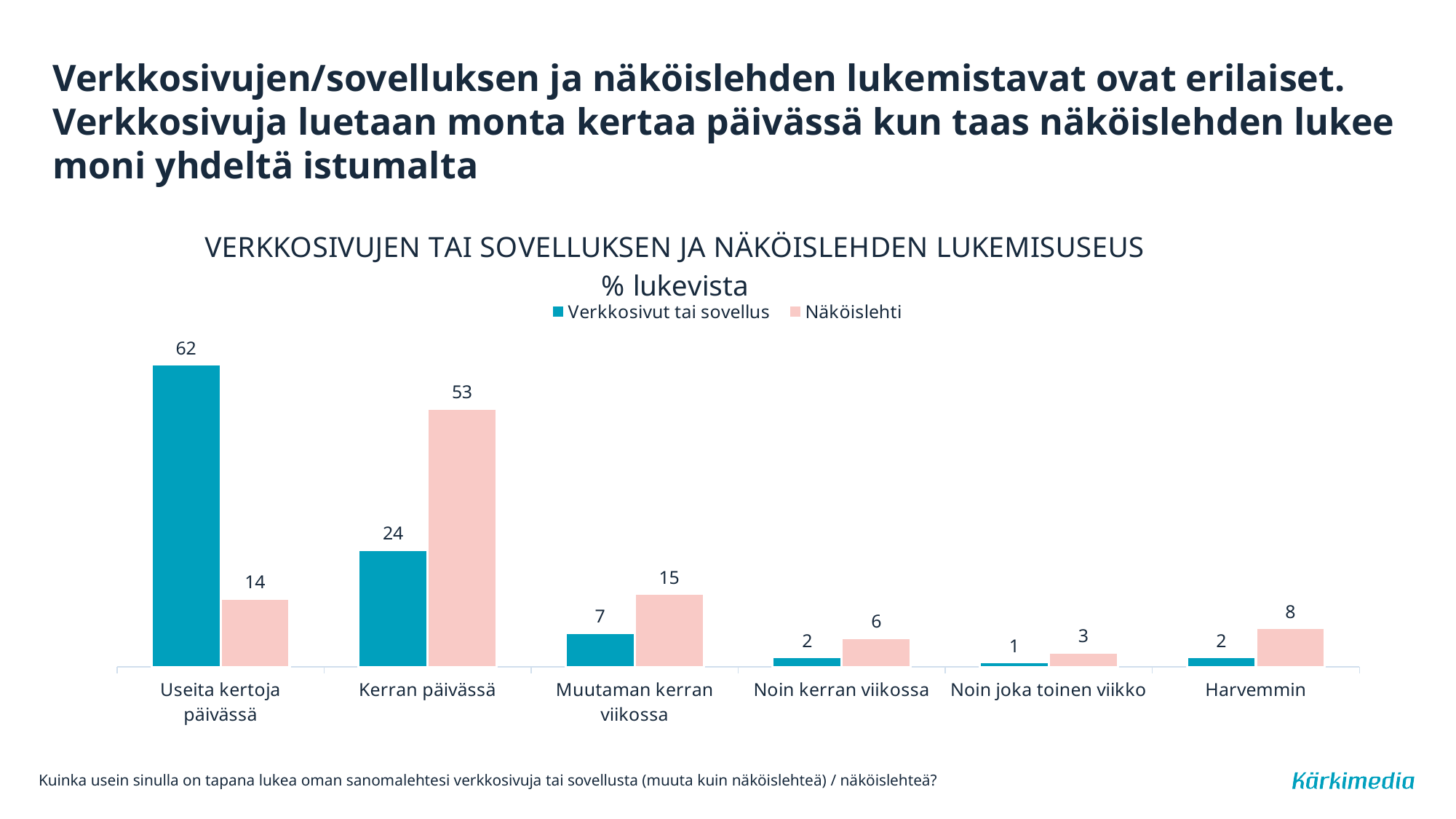
What is the difference between the "Verkkosivut tai sovellus" and "Näköislehti" values in the "Useita kertoja päivässä" category? 48 What kind of chart is shown on the slide? Bar chart What is the value for "Näköislehti" in the "Kerran päivässä" category? 53 Which category has the lowest value for the "Verkkosivut tai sovellus" series? Noin joka toinen viikko How many categories are shown on the x axis? 6 What is the title of the chart? VERKKOSIVUJEN TAI SOVELLUKSEN JA NÄKÖISLEHDEN LUKEMISUSEUS % lukevista What is the difference between the "Näköislehti" and "Verkkosivut tai sovellus" values in the "Kerran päivässä" category? 29 How many series does the legend list? 2 What is the value for "Näköislehti" in the "Harvemmin" category? 8 What is the value for "Verkkosivut tai sovellus" in the "Useita kertoja päivässä" category? 62 In the "Muutaman kerran viikossa" category, which series has the larger value? Näköislehti Which category has the highest value for the "Näköislehti" series? Kerran päivässä